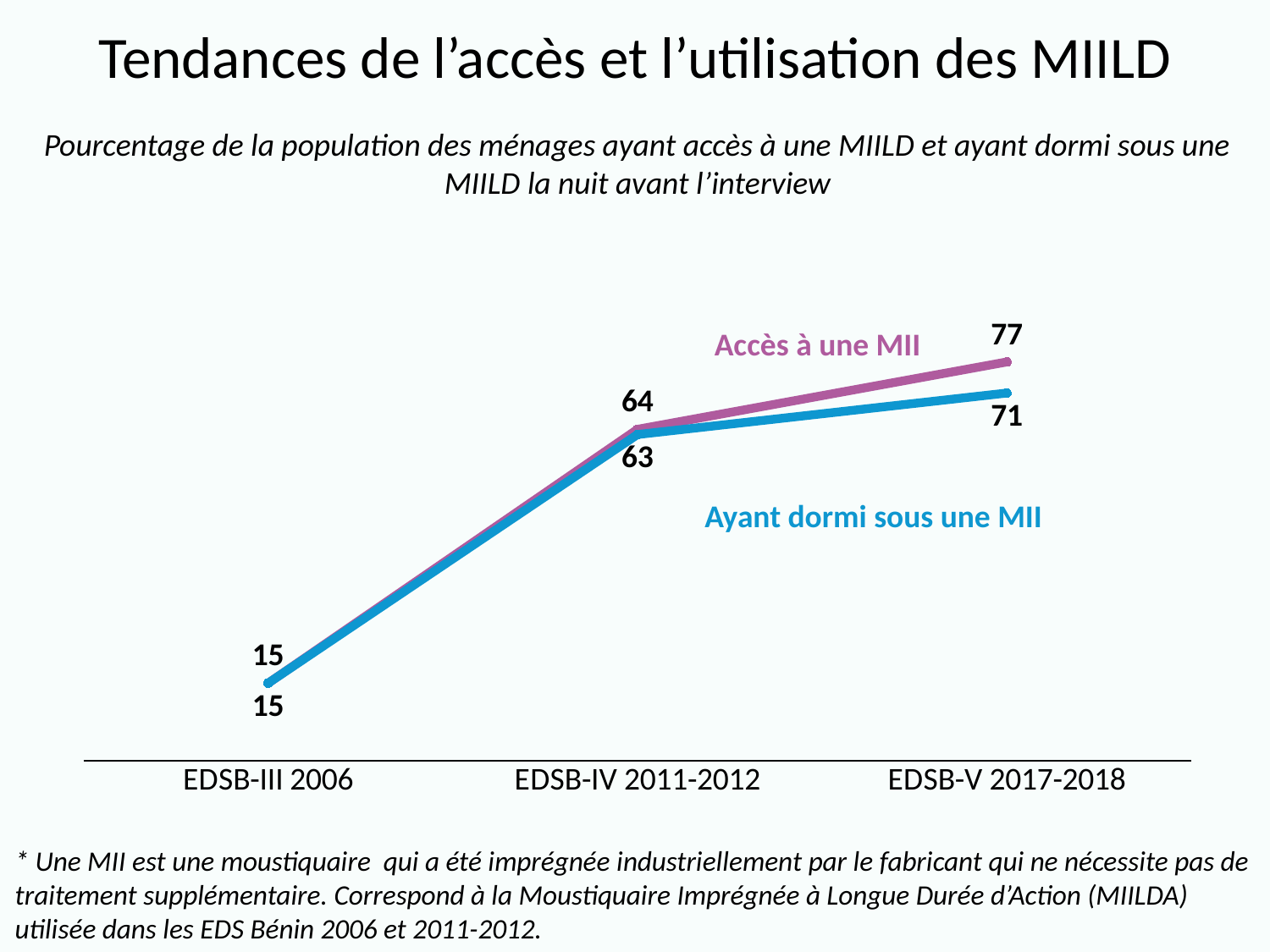
What is the value for 'Accès à une MII' at EDSB-III 2006? 15 At which survey is the value for 'Ayant dormi sous une MII' lowest? EDSB-III 2006 By how much did 'Accès à une MII' increase from EDSB-III 2006 to EDSB-IV 2011-2012? 49 Do the values for 'Ayant dormi sous une MII' rise or fall across the surveys from 2006 to 2017-2018? rise What is the difference between 'Accès à une MII' and 'Ayant dormi sous une MII' at EDSB-V 2017-2018? 6 What type of chart is shown on the slide? line chart At which survey is the value for 'Accès à une MII' highest? EDSB-V 2017-2018 What is the value for 'Accès à une MII' at EDSB-V 2017-2018? 77 What is the value for 'Ayant dormi sous une MII' at EDSB-V 2017-2018? 71 What is the value for 'Ayant dormi sous une MII' at EDSB-IV 2011-2012? 63 Which series has the larger value at EDSB-V 2017-2018, 'Accès à une MII' or 'Ayant dormi sous une MII'? Accès à une MII How many survey points are plotted along the x axis? 3